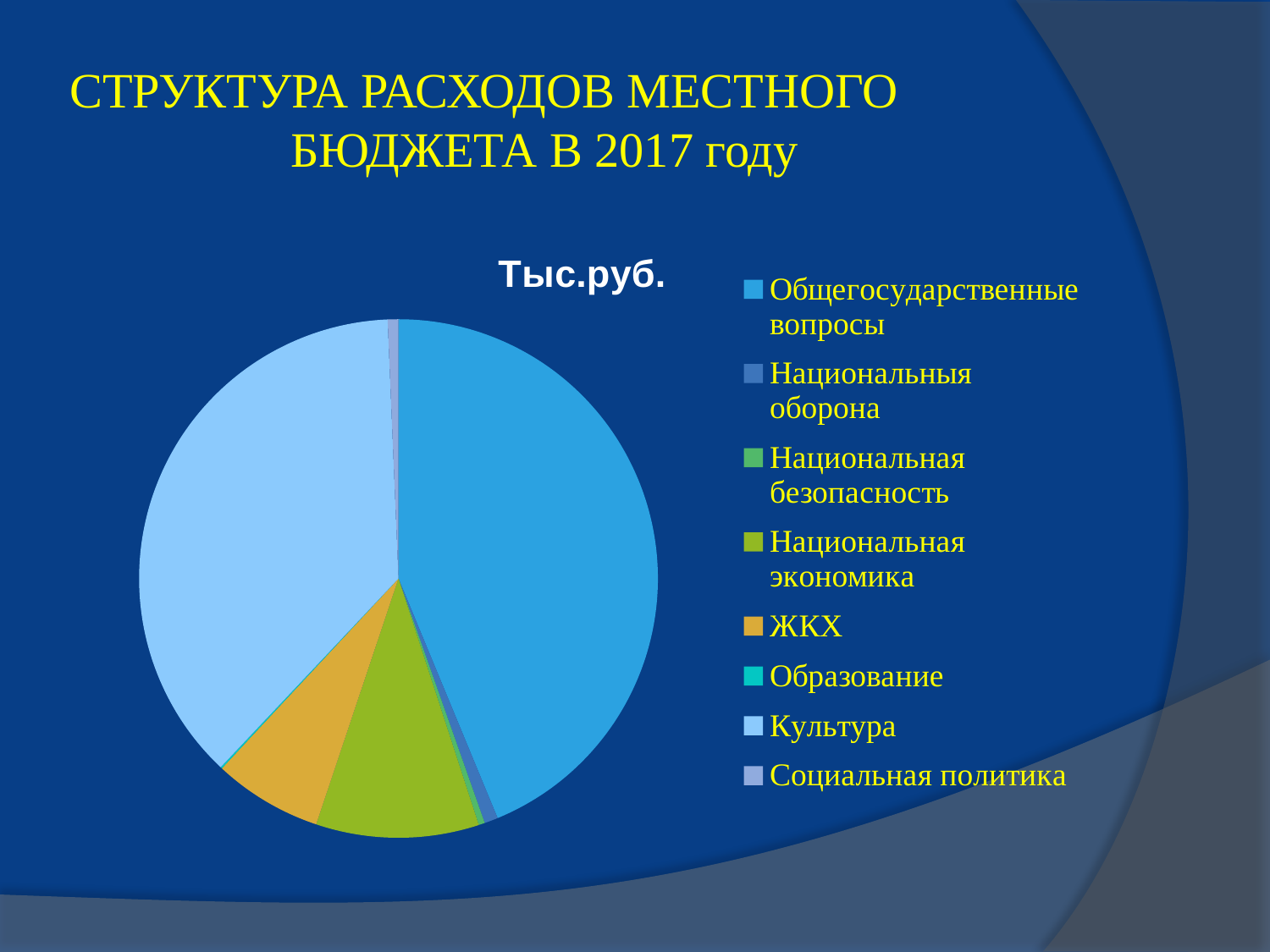
Which slice is larger: Национальная экономика or ЖКХ? Национальная экономика Which category is the second-largest slice of the pie? Культура What colour is the ЖКХ slice in the pie chart? orange Which slice is larger: Культура or Национальная экономика? Культура What is the title of the chart? Тыс.руб. How many categories does the pie chart's legend list? 8 Which slice is larger: Общегосударственные вопросы or Культура? Общегосударственные вопросы Which category has the largest slice of the pie? Общегосударственные вопросы What kind of chart is shown on the slide? pie chart